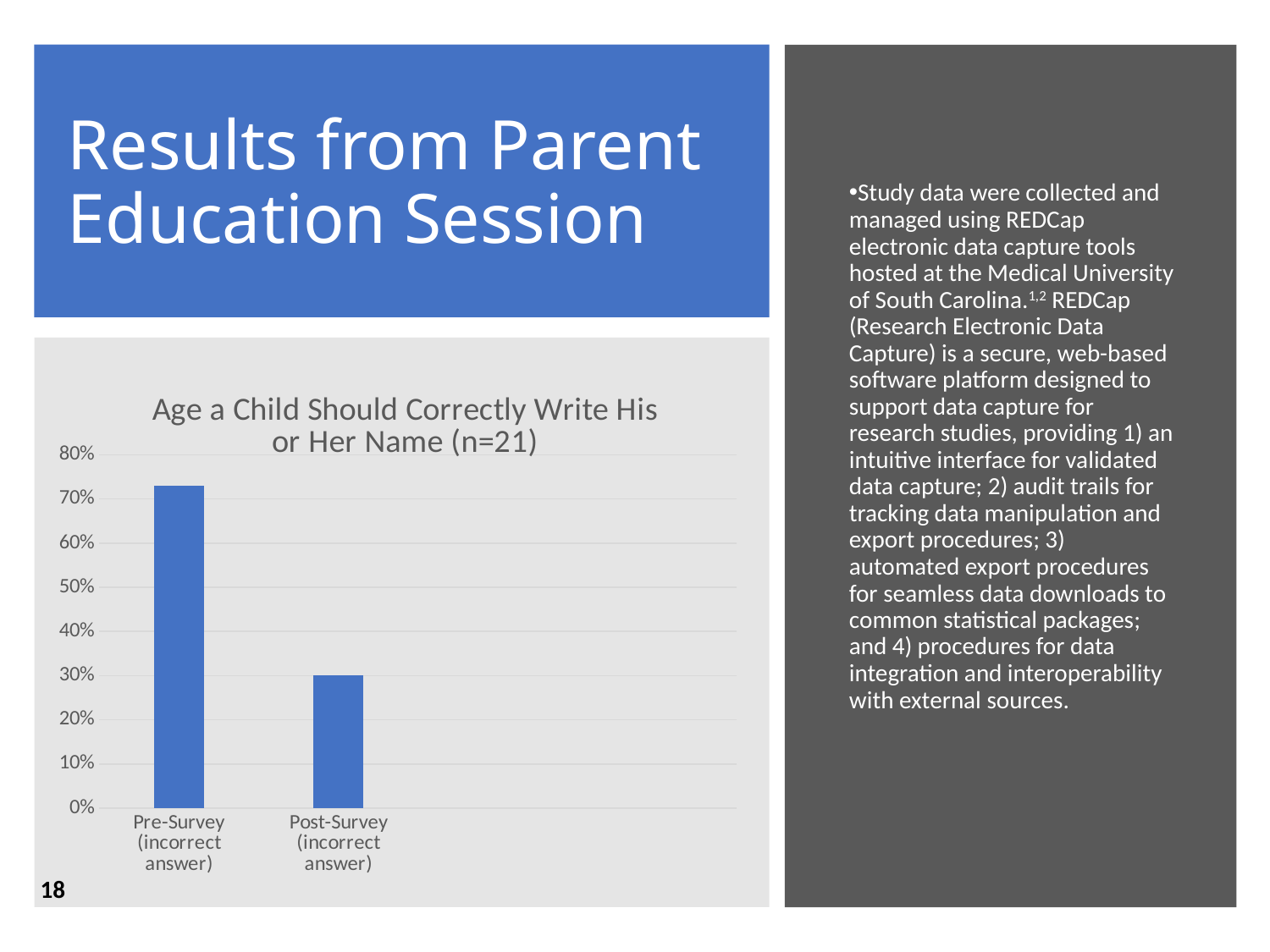
Do the values rise or fall from Pre-Survey to Post-Survey? fall Is the value for Pre-Survey (incorrect answer) greater or less than 70%? greater Which category has the highest value? Pre-Survey (incorrect answer) What sample size is stated in the chart title? n=21 Which category has the lowest value? Post-Survey (incorrect answer) What type of chart is shown on the slide? bar chart Is the value for Pre-Survey (incorrect answer) greater or less than 80%? less Is the value for Post-Survey (incorrect answer) greater or less than 40%? less Which is larger, the value for Pre-Survey (incorrect answer) or Post-Survey (incorrect answer)? Pre-Survey (incorrect answer) What is the title of the chart? Age a Child Should Correctly Write His or Her Name (n=21) How many categories are plotted in the chart? 2